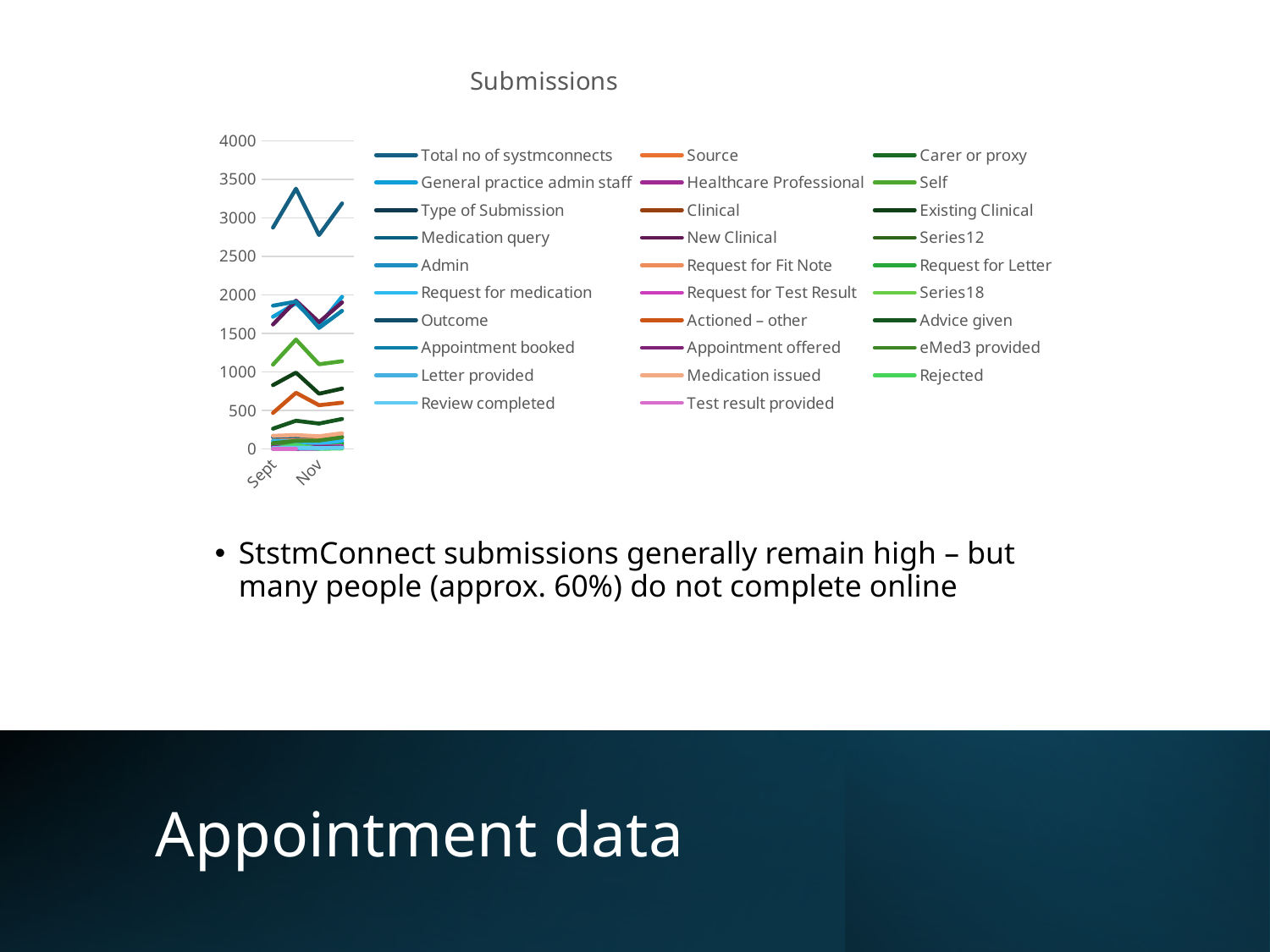
How many series does the chart's legend list? 29 Is the value for Total no of systmconnects at Sept greater or less than 3500? less What type of chart is shown on the slide? line chart What are the two month labels shown on the x axis? Sept and Nov What is the title of the chart? Submissions Which series has the highest values in the chart? Total no of systmconnects Does the Total no of systmconnects line rise or fall from Sept to the next point? rise Is the value for Total no of systmconnects at Sept greater or less than 2500? greater